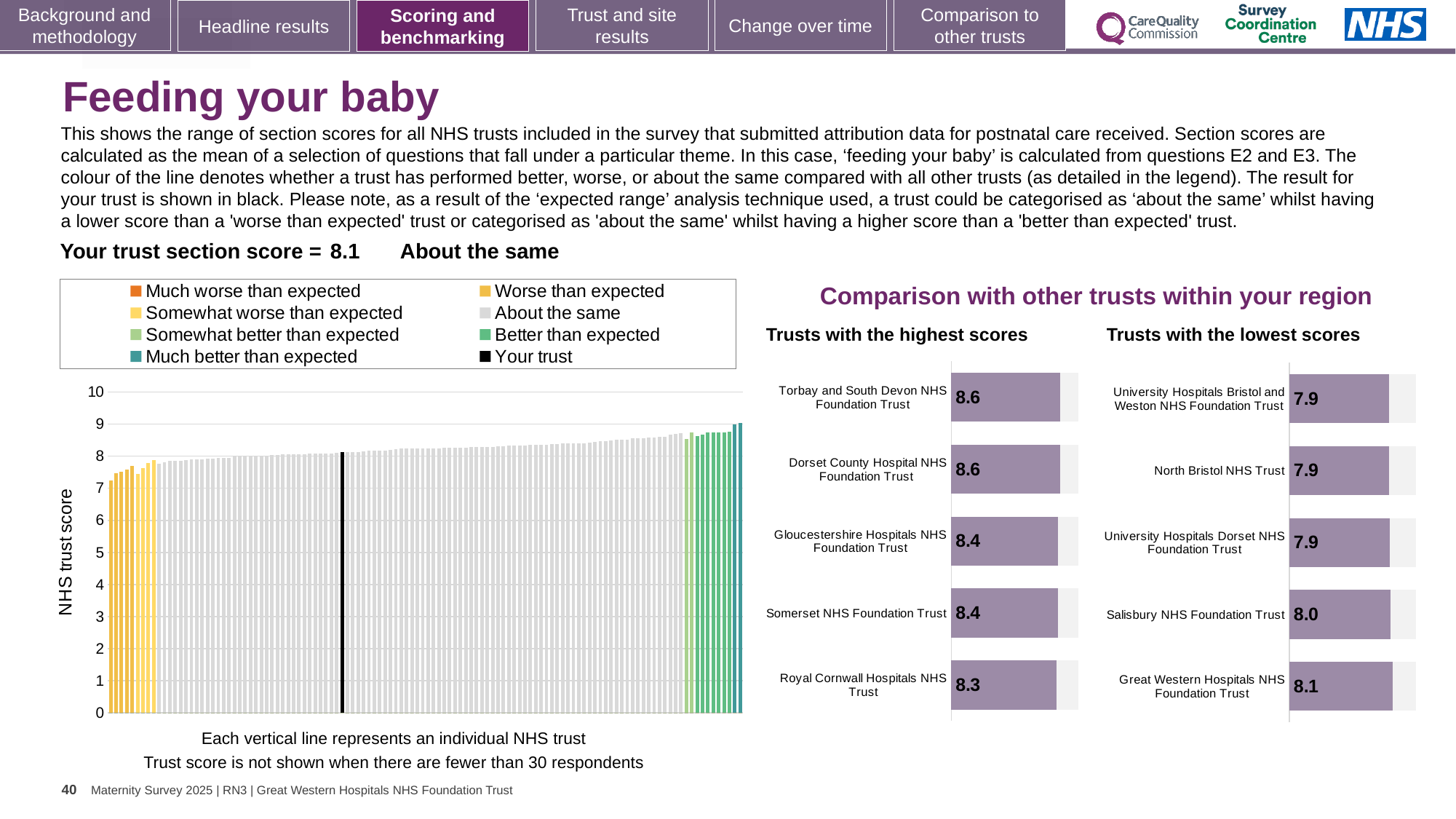
In the 'Trusts with the lowest scores' chart, which has the larger score: Salisbury NHS Foundation Trust or North Bristol NHS Trust? Salisbury NHS Foundation Trust In the 'Trusts with the highest scores' chart, what is the score for Torbay and South Devon NHS Foundation Trust? 8.6 In the 'Trusts with the highest scores' chart, what is the score for Gloucestershire Hospitals NHS Foundation Trust? 8.4 In the 'Trusts with the lowest scores' chart, what is the score for Great Western Hospitals NHS Foundation Trust? 8.1 How many trusts are shown in the 'Trusts with the highest scores' chart? 5 In the main chart on the left, do the bar values rise or fall from left to right? rise In the 'Trusts with the lowest scores' chart, which trust has the highest score? Great Western Hospitals NHS Foundation Trust In the main chart on the left, is the value of the leftmost bar greater or less than 8? less In the 'Trusts with the lowest scores' chart, what is the score for Salisbury NHS Foundation Trust? 8.0 In the 'Trusts with the highest scores' chart, which trust has the lowest score? Royal Cornwall Hospitals NHS Trust In the 'Trusts with the highest scores' chart, what is the difference between the scores of Torbay and South Devon NHS Foundation Trust and Royal Cornwall Hospitals NHS Trust? 0.3 How many entries does the legend of the main chart on the left list? 8